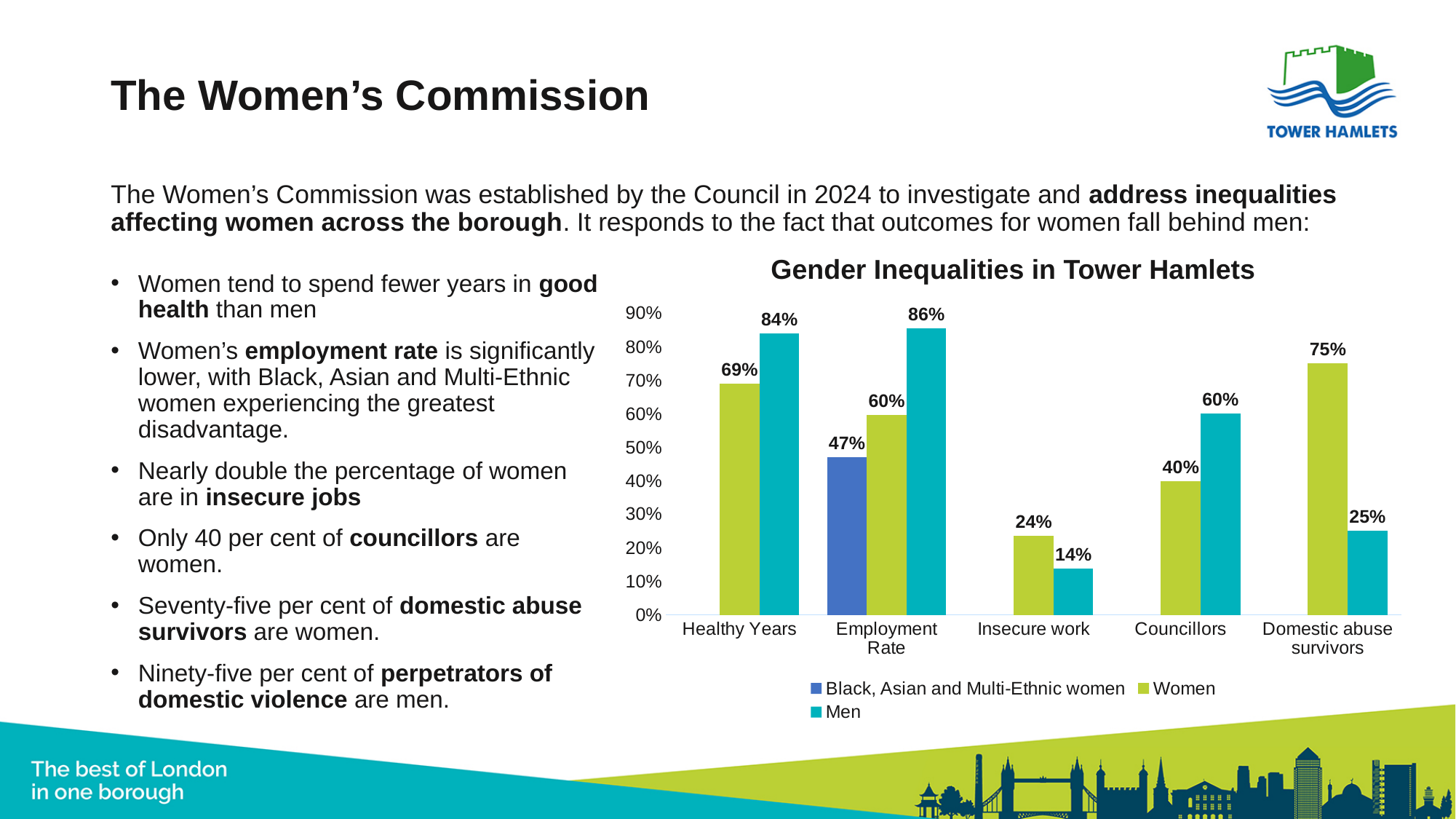
How many categories are shown on the x axis? 5 What is the value for Men in the Employment Rate category? 86% What is the value for Men in the Insecure work category? 14% Which category has the highest value for Women? Domestic abuse survivors Which category has the lowest value for Men? Insecure work What is the value for Women in the Healthy Years category? 69% What is the title of the chart? Gender Inequalities in Tower Hamlets What is the value for Black, Asian and Multi-Ethnic women in the Employment Rate category? 47% What kind of chart is shown on the slide? Bar chart How many series does the legend list? 3 What is the difference between the Men and Women values in the Employment Rate category? 26% Which is larger in the Councillors category, the value for Women or the value for Men? Men